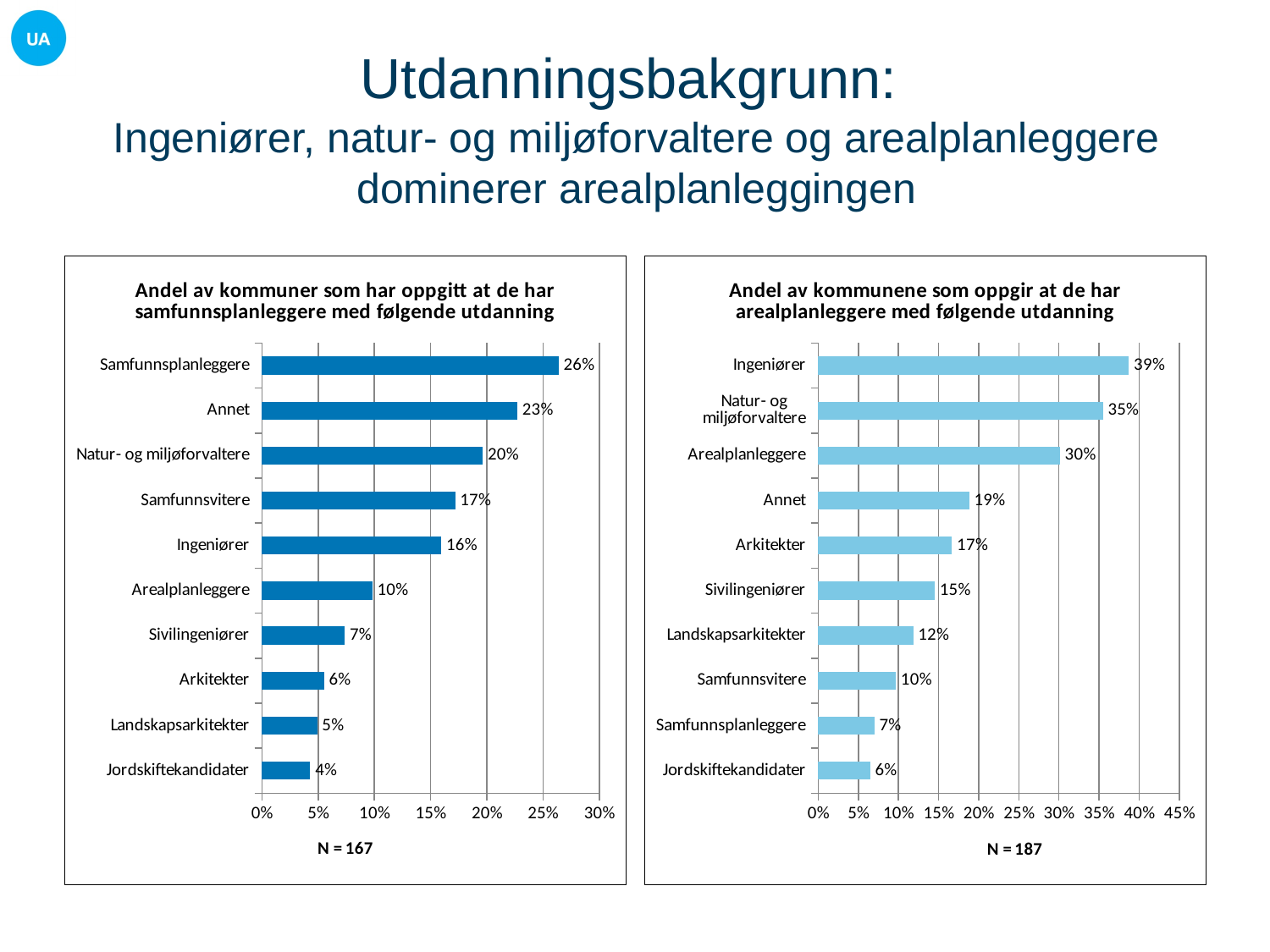
In the right chart (arealplanleggere), which category has the lowest value? Jordskiftekandidater In the left chart (samfunnsplanleggere), what is the value for Jordskiftekandidater? 4% In the left chart (samfunnsplanleggere), is the value for Natur- og miljøforvaltere greater or less than 15%? greater In the right chart (arealplanleggere), what is the value for Arkitekter? 17% In the left chart (samfunnsplanleggere), which category has the highest value? Samfunnsplanleggere In the left chart (samfunnsplanleggere), what is the value for Samfunnsvitere? 17% What kind of chart is the left chart (samfunnsplanleggere)? Bar chart What is the N value shown below the right chart (arealplanleggere)? N = 187 How many categories are shown in the right chart (arealplanleggere)? 10 In the right chart (arealplanleggere), which is larger: Sivilingeniører or Landskapsarkitekter? Sivilingeniører In the left chart (samfunnsplanleggere), what is the difference between Annet and Ingeniører? 7% In the right chart (arealplanleggere), what is the difference between Ingeniører and Arealplanleggere? 9%